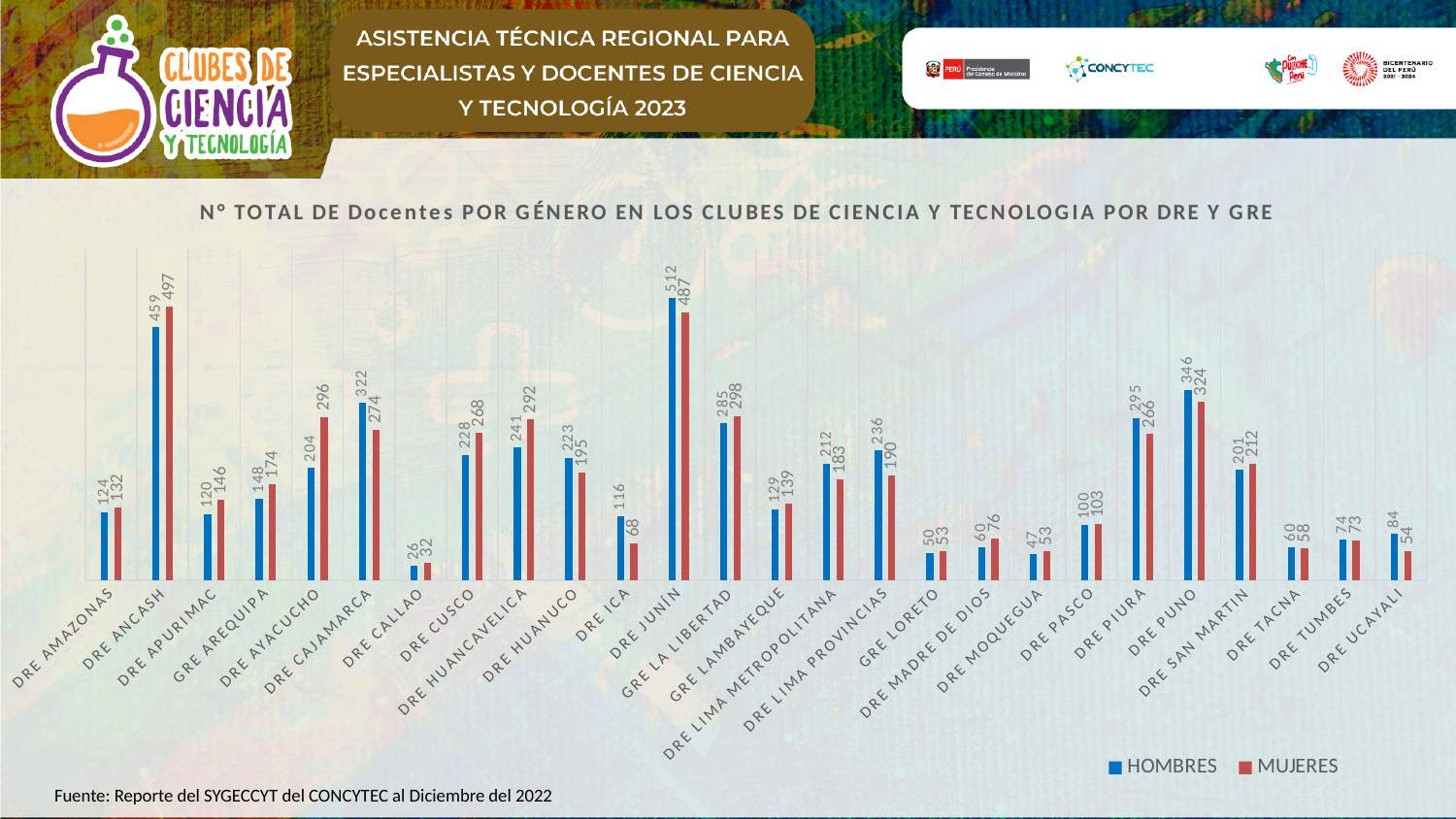
What is the difference between the HOMBRES and MUJERES values for DRE ICA? 48 Which region has the lowest MUJERES value? DRE CALLAO How many regions (DRE/GRE categories) are shown on the x axis? 26 What are the two legend entries of the chart? HOMBRES and MUJERES How many series does the legend list? 2 What is the MUJERES value for GRE LA LIBERTAD? 298 For DRE CAJAMARCA, which is larger, HOMBRES or MUJERES? HOMBRES What is the difference between the MUJERES and HOMBRES values for DRE ANCASH? 38 What is the MUJERES value for DRE AYACUCHO? 296 What is the HOMBRES value for DRE ANCASH? 459 What type of chart is shown on the slide? Bar chart Which region has the highest HOMBRES value? DRE JUNÍN